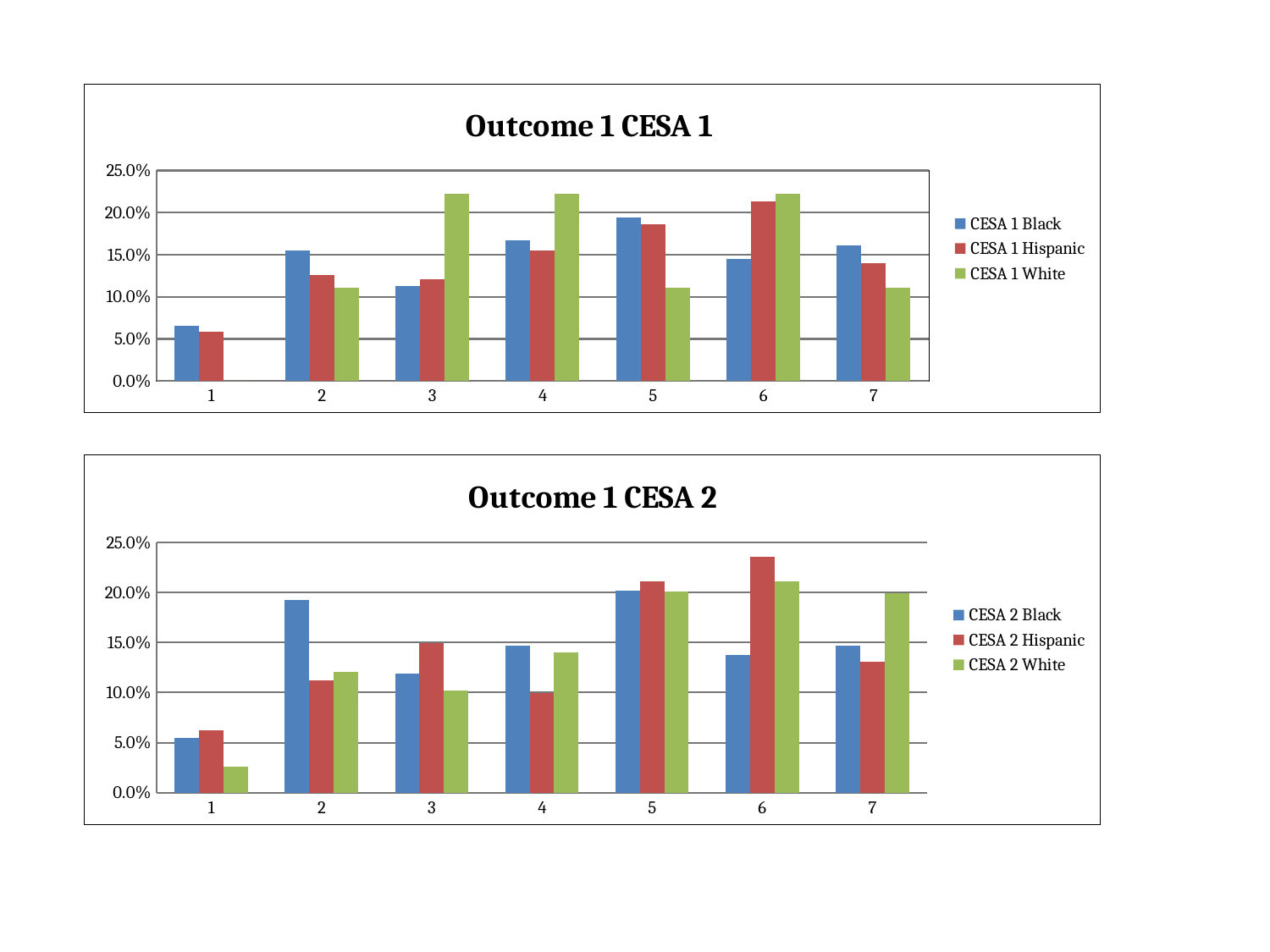
In the "Outcome 1 CESA 2" chart, which series and category has the highest bar? CESA 2 Hispanic at category 6 In the "Outcome 1 CESA 1" chart, how many series does the legend list? 3 In the "Outcome 1 CESA 1" chart, is the value for CESA 1 Black at category 5 greater or less than 15.0%? greater In the "Outcome 1 CESA 2" chart, is the value for CESA 2 Black at category 2 greater or less than 15.0%? greater In the "Outcome 1 CESA 2" chart, at category 4, which is larger: CESA 2 Black or CESA 2 Hispanic? CESA 2 Black In the "Outcome 1 CESA 1" chart, how many categories are shown on the x axis? 7 In the "Outcome 1 CESA 1" chart, is the value for CESA 1 White at category 2 greater or less than 15.0%? less In the "Outcome 1 CESA 1" chart, at category 3, which is larger: CESA 1 Black or CESA 1 White? CESA 1 White What are the legend entries in the "Outcome 1 CESA 2" chart? CESA 2 Black, CESA 2 Hispanic, CESA 2 White What kind of chart is "Outcome 1 CESA 1"? bar chart In the "Outcome 1 CESA 2" chart, which series and category has the lowest bar? CESA 2 White at category 1